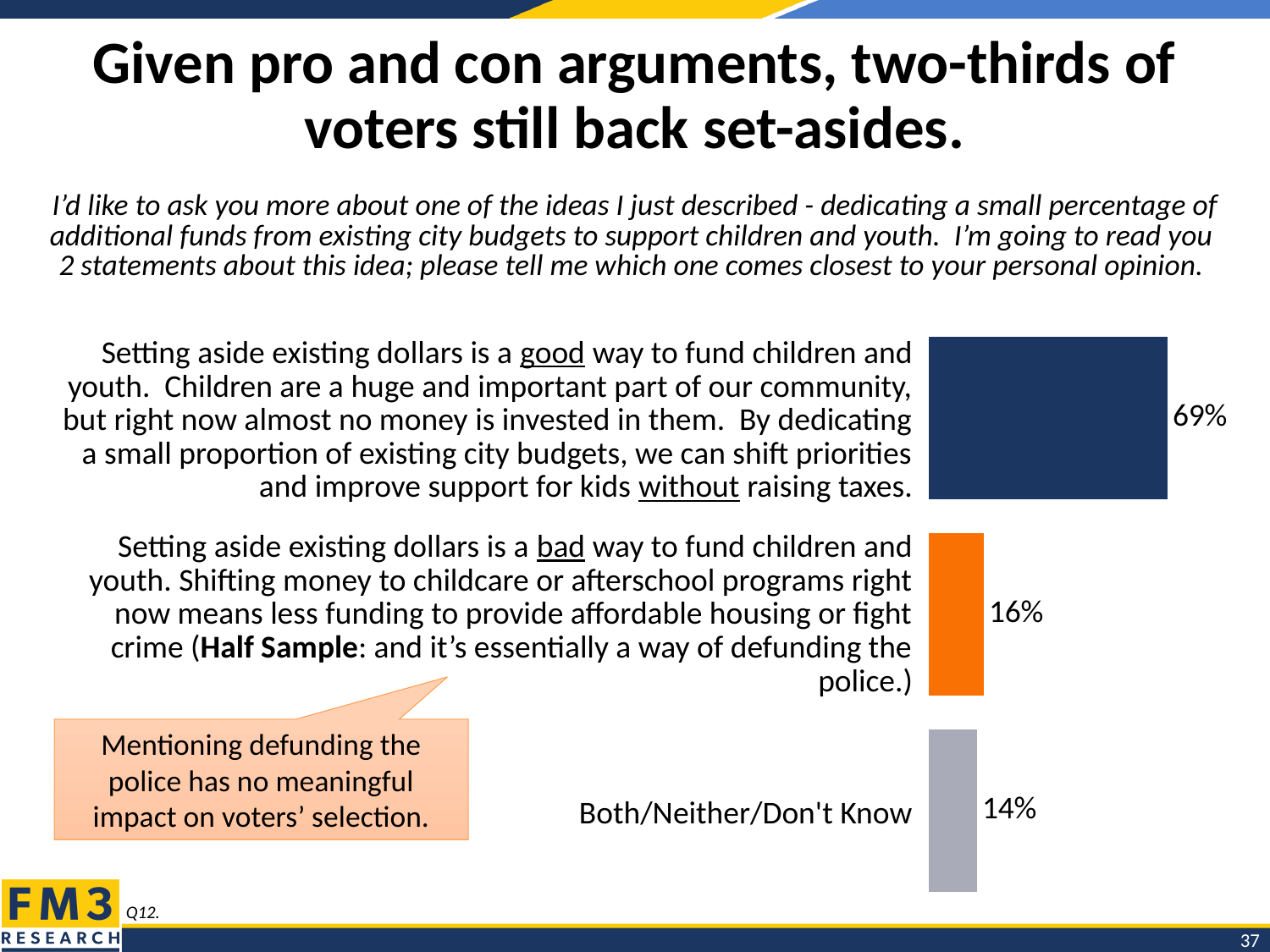
What is the difference in percentage points between the 'bad way' statement and Both/Neither/Don't Know? 2 Which is larger: the share choosing the 'good way' statement or the share choosing the 'bad way' statement? The 'good way' statement What colour is the bar for the 'bad way' statement? Orange What percentage of voters chose the statement that setting aside existing dollars is a good way to fund children and youth? 69% How many response categories are shown in the chart? 3 What type of chart is shown on the slide? Bar chart What does the callout box on the slide say about mentioning defunding the police? It has no meaningful impact on voters' selection. What is the difference in percentage points between the 'good way' statement and the 'bad way' statement? 53 What percentage of voters chose the statement that setting aside existing dollars is a bad way to fund children and youth? 16% Which response category has the lowest value? Both/Neither/Don't Know Which response category has the highest value? Setting aside existing dollars is a good way to fund children and youth What percentage of voters answered Both/Neither/Don't Know? 14%